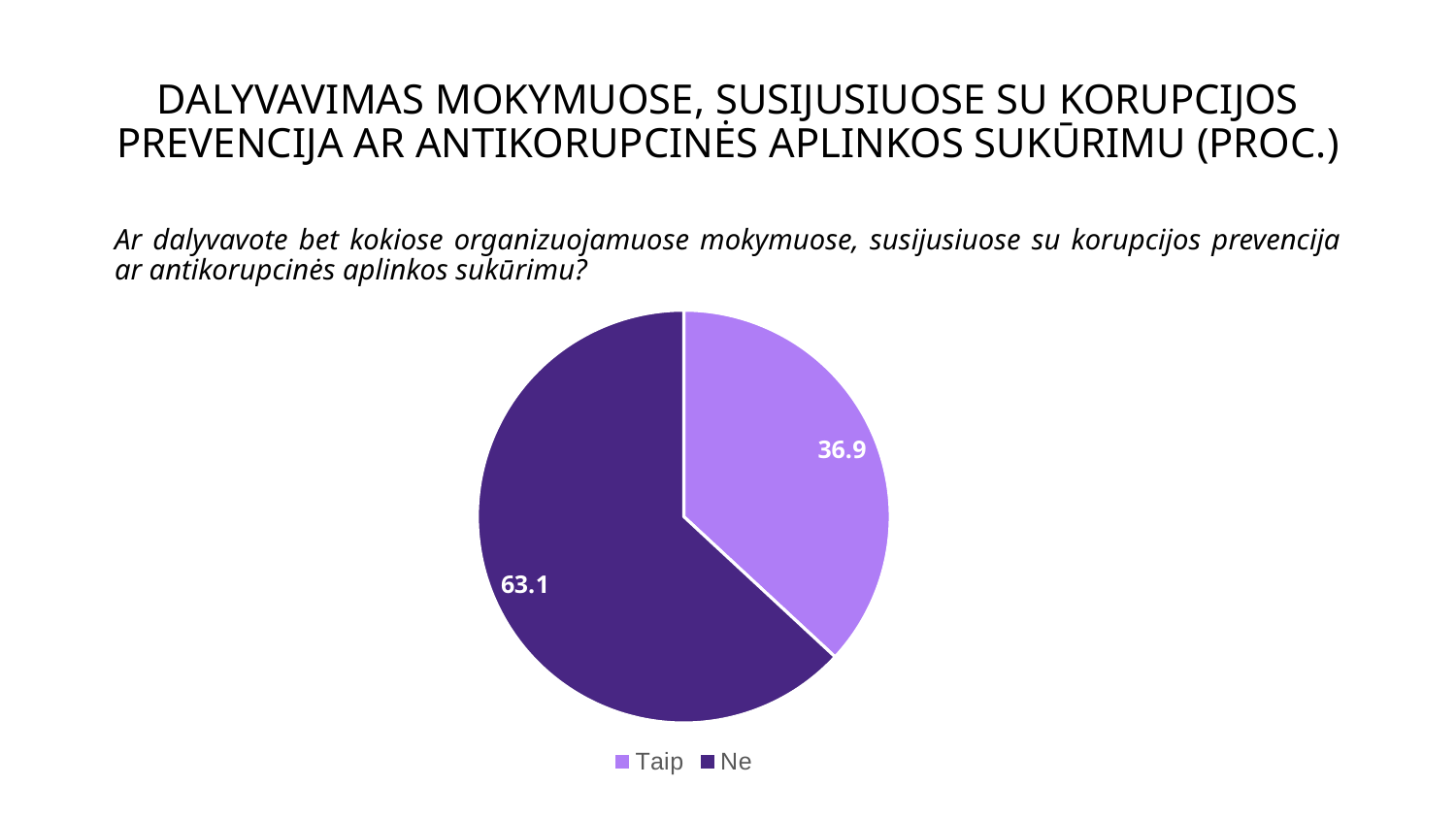
Which is larger, the value for "Taip" or the value for "Ne"? Ne What kind of chart is shown on the slide? pie chart What is the value for "Ne"? 63.1 Where is the legend positioned relative to the pie chart? below the chart Which category has the largest slice? Ne What is the value for "Taip"? 36.9 How many entries does the legend list? 2 Which category has the smallest slice? Taip What is the difference between the values for "Ne" and "Taip"? 26.2 What is the total of the two slice values? 100 How many slices does the pie chart have? 2 Which colour represents "Ne" in the pie chart? dark purple